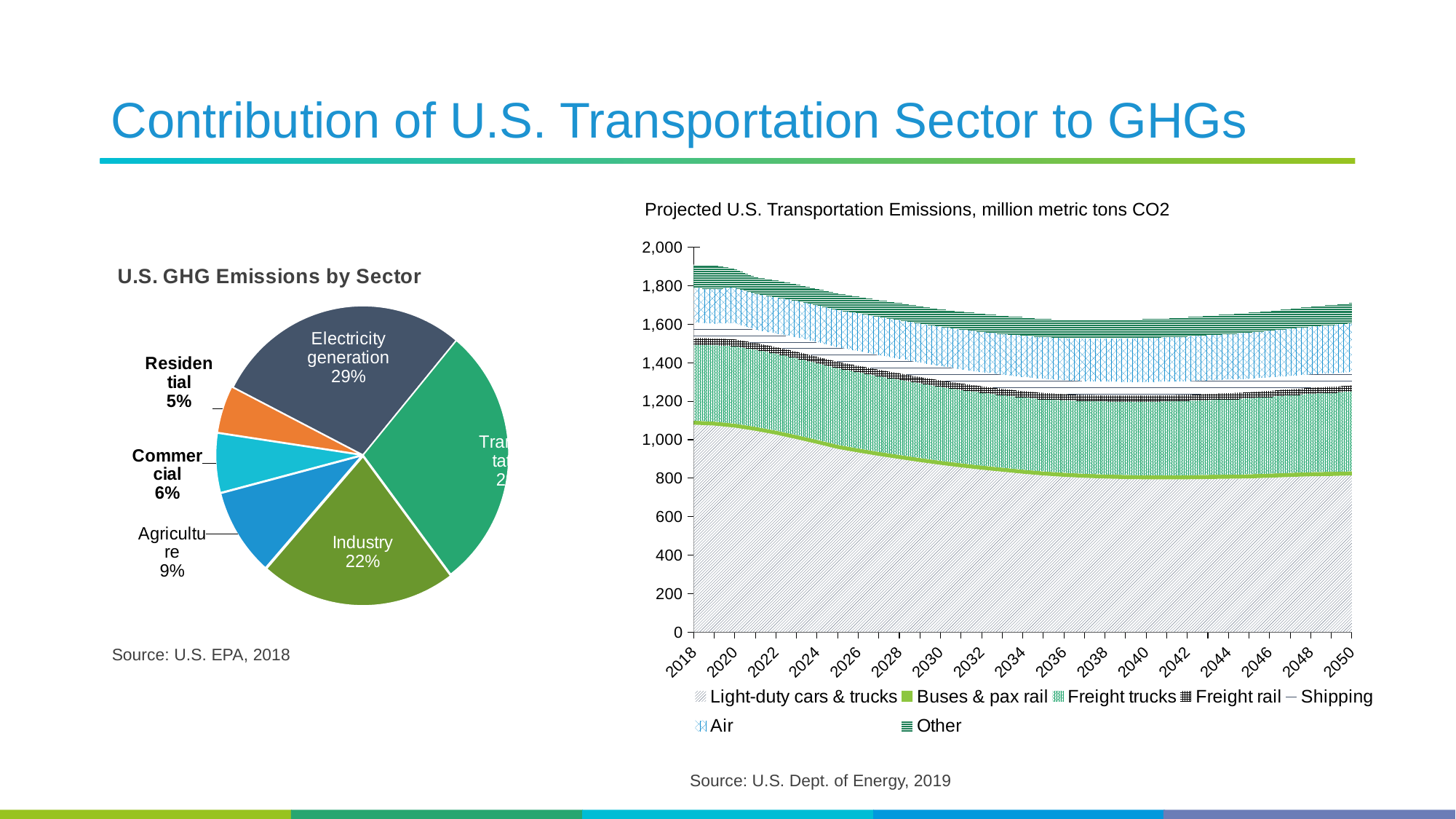
In the pie chart 'U.S. GHG Emissions by Sector', what share is Agriculture? 9% What source is cited below the 'Projected U.S. Transportation Emissions' chart? U.S. Dept. of Energy, 2019 In the 'Projected U.S. Transportation Emissions' chart, is the total stacked value in 2036 greater or less than 1,800? less In the pie chart 'U.S. GHG Emissions by Sector', what is the difference in percentage points between Industry and Agriculture? 13 How many series does the legend of the 'Projected U.S. Transportation Emissions' chart list? 7 What kind of chart is 'Projected U.S. Transportation Emissions, million metric tons CO2'? Stacked area chart In the pie chart 'U.S. GHG Emissions by Sector', what share is Electricity generation? 29% In the pie chart 'U.S. GHG Emissions by Sector', what share is Industry? 22% In the pie chart 'U.S. GHG Emissions by Sector', which sector has the smallest share? Residential In the pie chart 'U.S. GHG Emissions by Sector', which is larger, Commercial or Residential? Commercial In the 'Projected U.S. Transportation Emissions' chart, is the value for Light-duty cars & trucks in 2018 greater or less than 1,000? greater How many slices does the pie chart 'U.S. GHG Emissions by Sector' have? 6